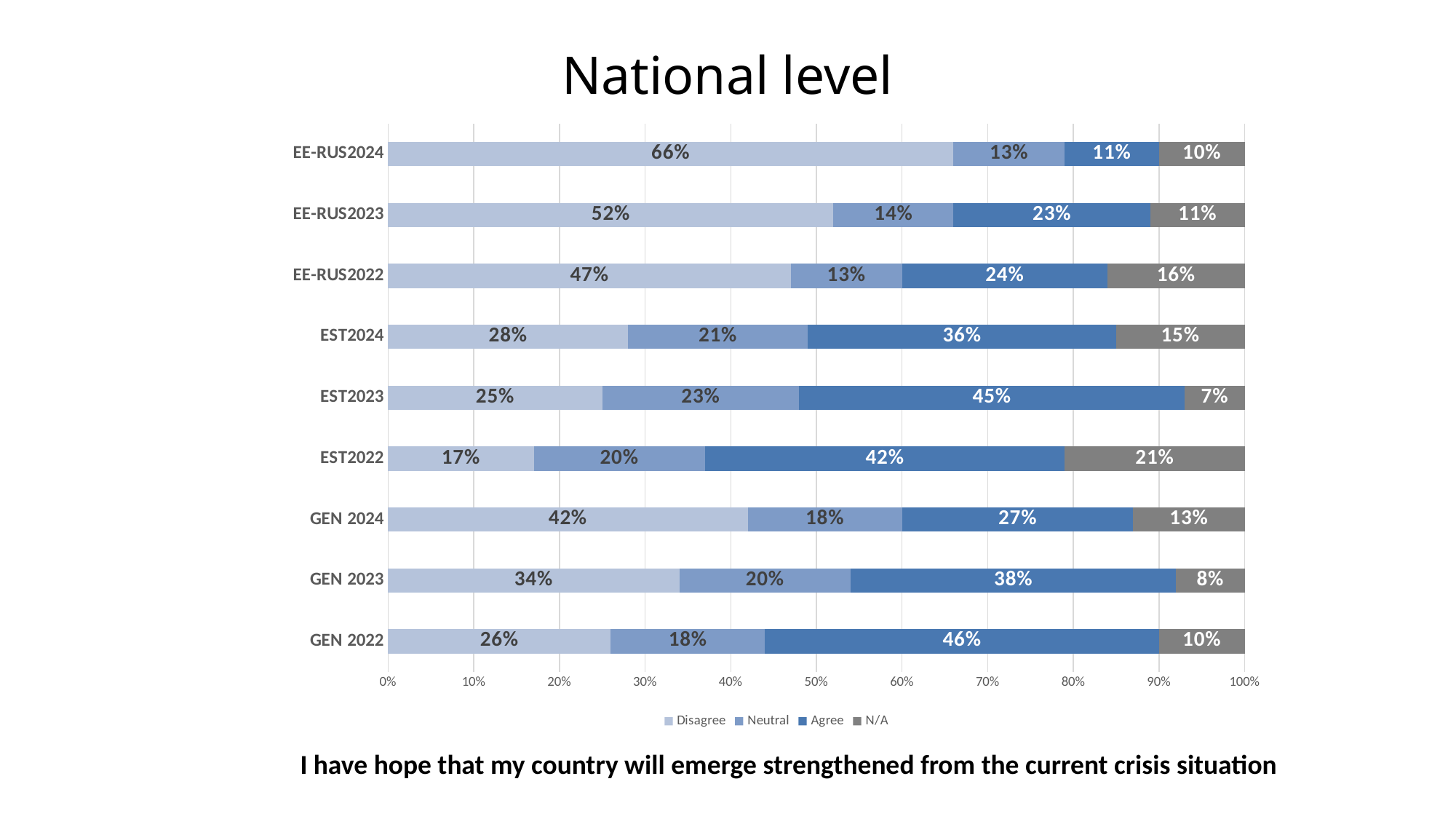
What is the Agree value for EST2023? 45% Which category has the lowest Agree value? EE-RUS2024 How many categories are shown on the y axis? 9 What is the Neutral value for GEN 2023? 20% How many series does the legend list? 4 What is the difference between the Agree values for GEN 2022 and GEN 2024? 19% Which category has the highest Disagree value? EE-RUS2024 Which is larger, the Disagree value for EST2024 or the Disagree value for GEN 2024? GEN 2024 What is the N/A value for EST2022? 21% What is the title of the chart? National level What is the Disagree value for EE-RUS2024? 66% What kind of chart is shown on the slide? Stacked bar chart